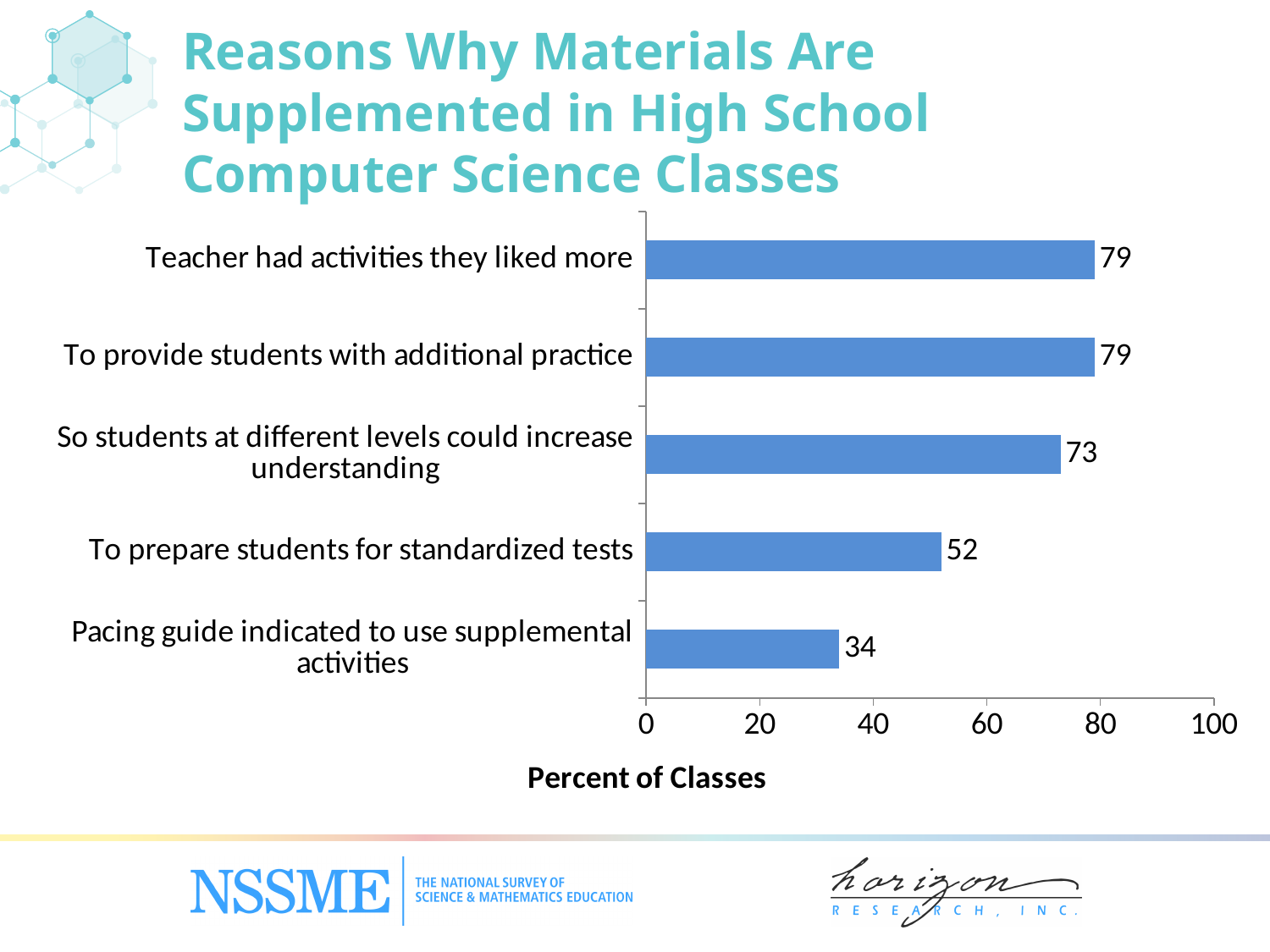
What is the difference between the values for "To provide students with additional practice" and "To prepare students for standardized tests"? 27 How many categories are shown in the chart? 5 What is the difference between the values for "So students at different levels could increase understanding" and "Pacing guide indicated to use supplemental activities"? 39 What is the value for "Teacher had activities they liked more"? 79 What is the value for "So students at different levels could increase understanding"? 73 Which is larger: the value for "So students at different levels could increase understanding" or the value for "To prepare students for standardized tests"? So students at different levels could increase understanding What is the value for "Pacing guide indicated to use supplemental activities"? 34 Is the value for "To prepare students for standardized tests" greater or less than 60? less What is the value for "To prepare students for standardized tests"? 52 What kind of chart is shown on the slide? bar chart What is the label of the horizontal axis? Percent of Classes Which category has the lowest value? Pacing guide indicated to use supplemental activities